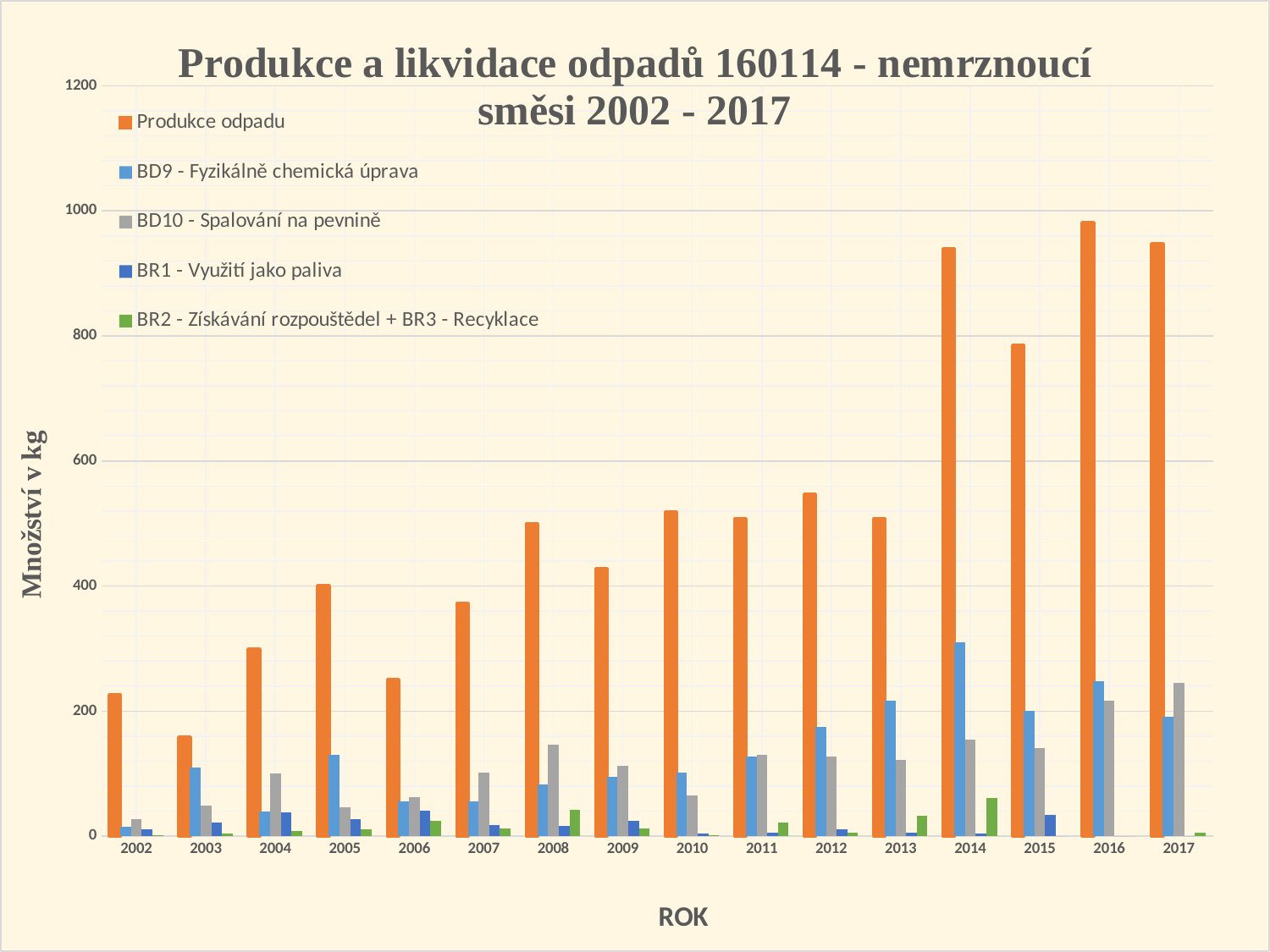
What kind of chart is shown on the slide? bar chart In which year is BD9 - Fyzikálně chemická úprava highest? 2014 Does Produkce odpadu generally rise or fall from 2002 to 2017? rise In which year is BR2 - Získávání rozpouštědel + BR3 - Recyklace highest? 2014 Which is larger: Produkce odpadu in 2004 or in 2006? 2004 Is the value of Produkce odpadu in 2014 greater or less than 800? greater In which year is Produkce odpadu lowest? 2003 Is the value of BD9 - Fyzikálně chemická úprava in 2014 greater or less than 200? greater In which year is Produkce odpadu highest? 2016 How many series does the legend list? 5 Is the value of Produkce odpadu in 2015 greater or less than 800? less How many years are shown on the x axis? 16